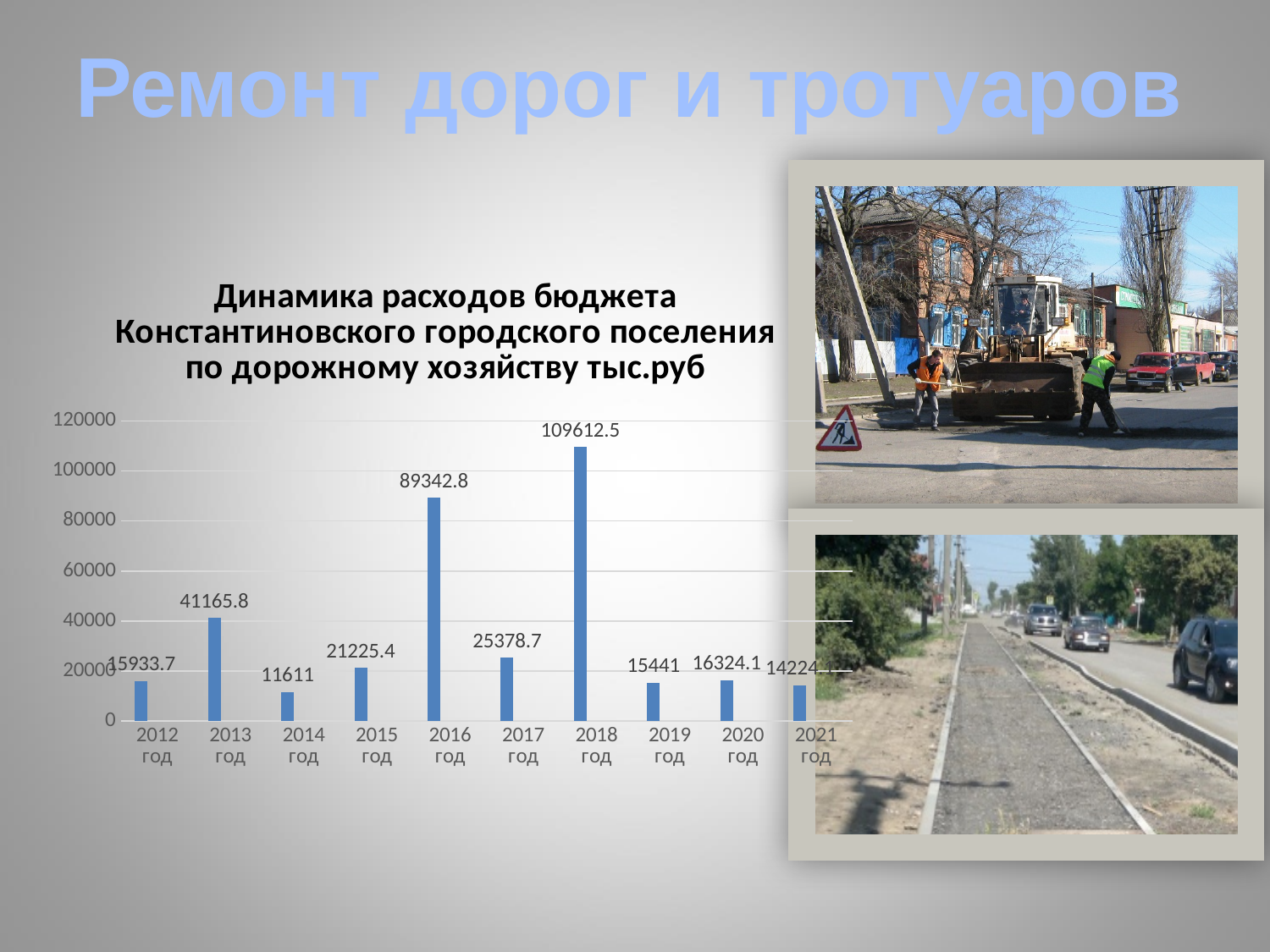
What type of chart is shown on the slide? bar chart What is the value for 2014 год? 11611 Which year has the highest value? 2018 год Which year has the lowest value? 2014 год Which is larger, the value for 2017 год or the value for 2015 год? 2017 год What is the value for 2018 год? 109612.5 What unit of measurement is stated in the chart title? тыс.руб What is the value for 2013 год? 41165.8 What is the value for 2016 год? 89342.8 Is the value for 2021 год greater or less than 20000? less How many years are shown on the x axis? 10 What is the difference between the values for 2018 год and 2016 год? 20269.7